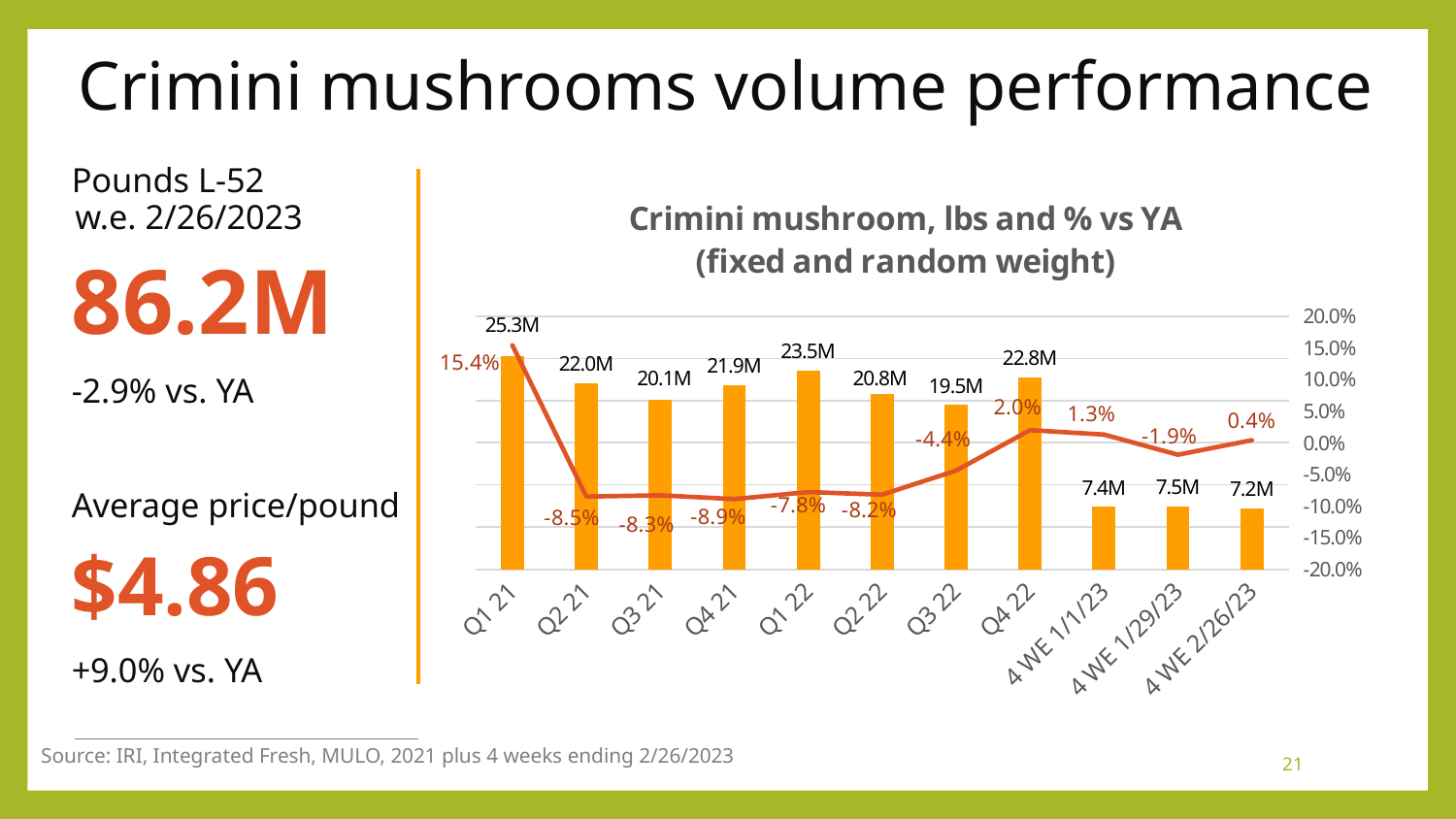
What kind of chart is shown on the slide? Bar chart with a line What is the volume in pounds for the 4 WE 2/26/23 period? 7.2M What is the volume in pounds for Q1 21? 25.3M How many periods are shown on the x axis of the chart? 11 Which period has the lowest % vs YA value? Q4 21 Is the % vs YA value for Q1 21 greater or less than 10.0%? greater What is the % vs YA value for Q3 22? -4.4% Does the % vs YA line rise or fall from Q2 22 to Q4 22? Rise Which period has the highest volume in pounds? Q1 21 What is the difference in pounds between Q1 22 and Q2 22? 2.7M Which has a higher volume in pounds, Q4 22 or Q2 21? Q4 22 What is the title of the chart? Crimini mushroom, lbs and % vs YA (fixed and random weight)